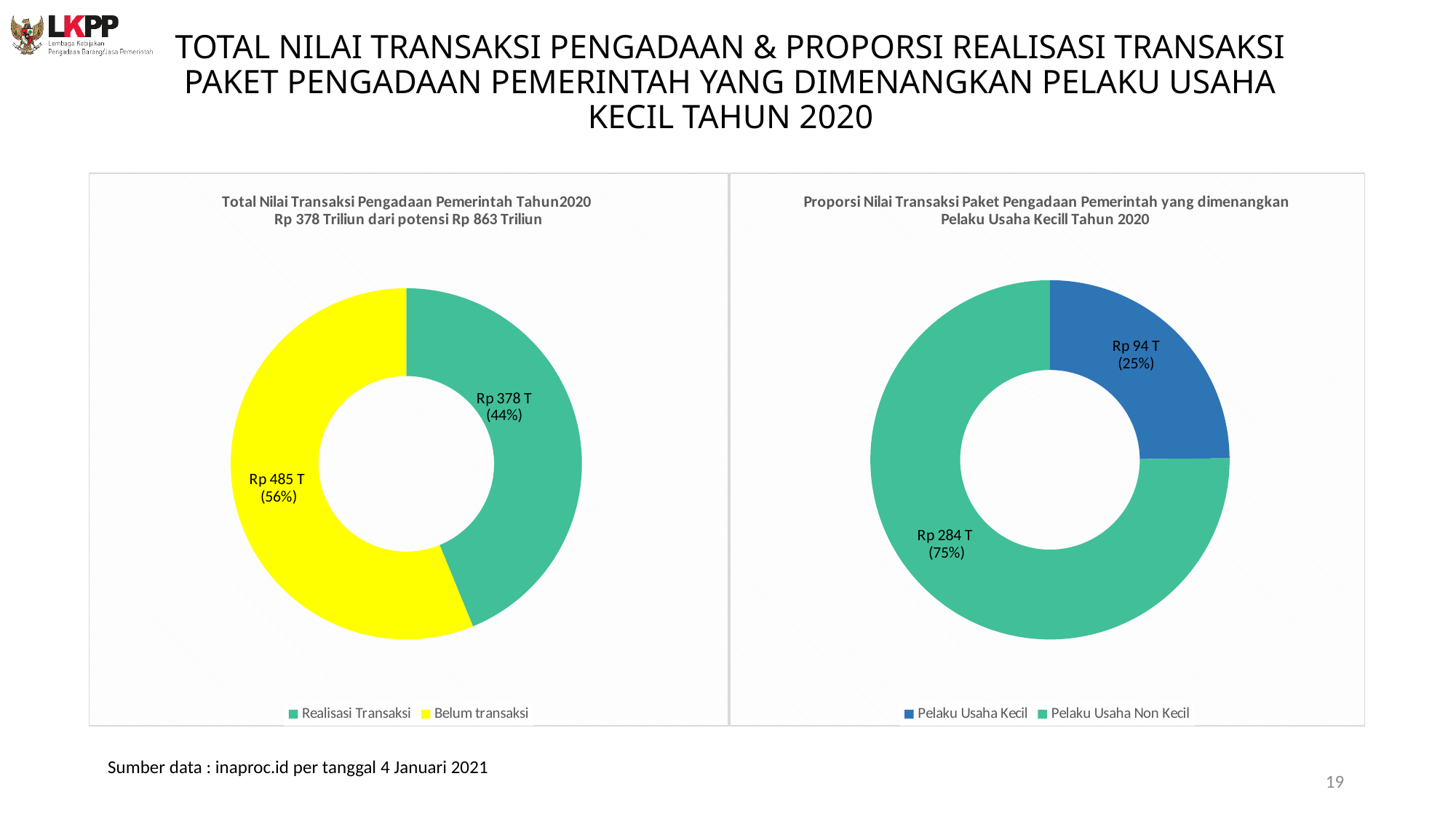
In the left chart (Total Nilai Transaksi Pengadaan Pemerintah Tahun 2020), which category is the largest? Belum transaksi How many categories does the legend of the right chart (Proporsi Nilai Transaksi Paket Pengadaan Pemerintah yang dimenangkan Pelaku Usaha Kecil Tahun 2020) list? 2 In the left chart (Total Nilai Transaksi Pengadaan Pemerintah Tahun 2020), what is the value for Belum transaksi? Rp 485 T In the right chart (Proporsi Nilai Transaksi Paket Pengadaan Pemerintah yang dimenangkan Pelaku Usaha Kecil Tahun 2020), what is the value for Pelaku Usaha Kecil? Rp 94 T What kind of chart is the left chart (Total Nilai Transaksi Pengadaan Pemerintah Tahun 2020)? Doughnut (pie) chart In the left chart (Total Nilai Transaksi Pengadaan Pemerintah Tahun 2020), what share of the pie is Belum transaksi? 56% In the right chart (Proporsi Nilai Transaksi Paket Pengadaan Pemerintah yang dimenangkan Pelaku Usaha Kecil Tahun 2020), which category is the smallest? Pelaku Usaha Kecil In the left chart (Total Nilai Transaksi Pengadaan Pemerintah Tahun 2020), what is the value for Realisasi Transaksi? Rp 378 T In the right chart (Proporsi Nilai Transaksi Paket Pengadaan Pemerintah yang dimenangkan Pelaku Usaha Kecil Tahun 2020), what is the value for Pelaku Usaha Non Kecil? Rp 284 T In the right chart (Proporsi Nilai Transaksi Paket Pengadaan Pemerintah yang dimenangkan Pelaku Usaha Kecil Tahun 2020), which is larger: Pelaku Usaha Kecil or Pelaku Usaha Non Kecil? Pelaku Usaha Non Kecil In the left chart (Total Nilai Transaksi Pengadaan Pemerintah Tahun 2020), what is the difference between Belum transaksi and Realisasi Transaksi? Rp 107 T In the right chart (Proporsi Nilai Transaksi Paket Pengadaan Pemerintah yang dimenangkan Pelaku Usaha Kecil Tahun 2020), what share of the pie is Pelaku Usaha Kecil? 25%